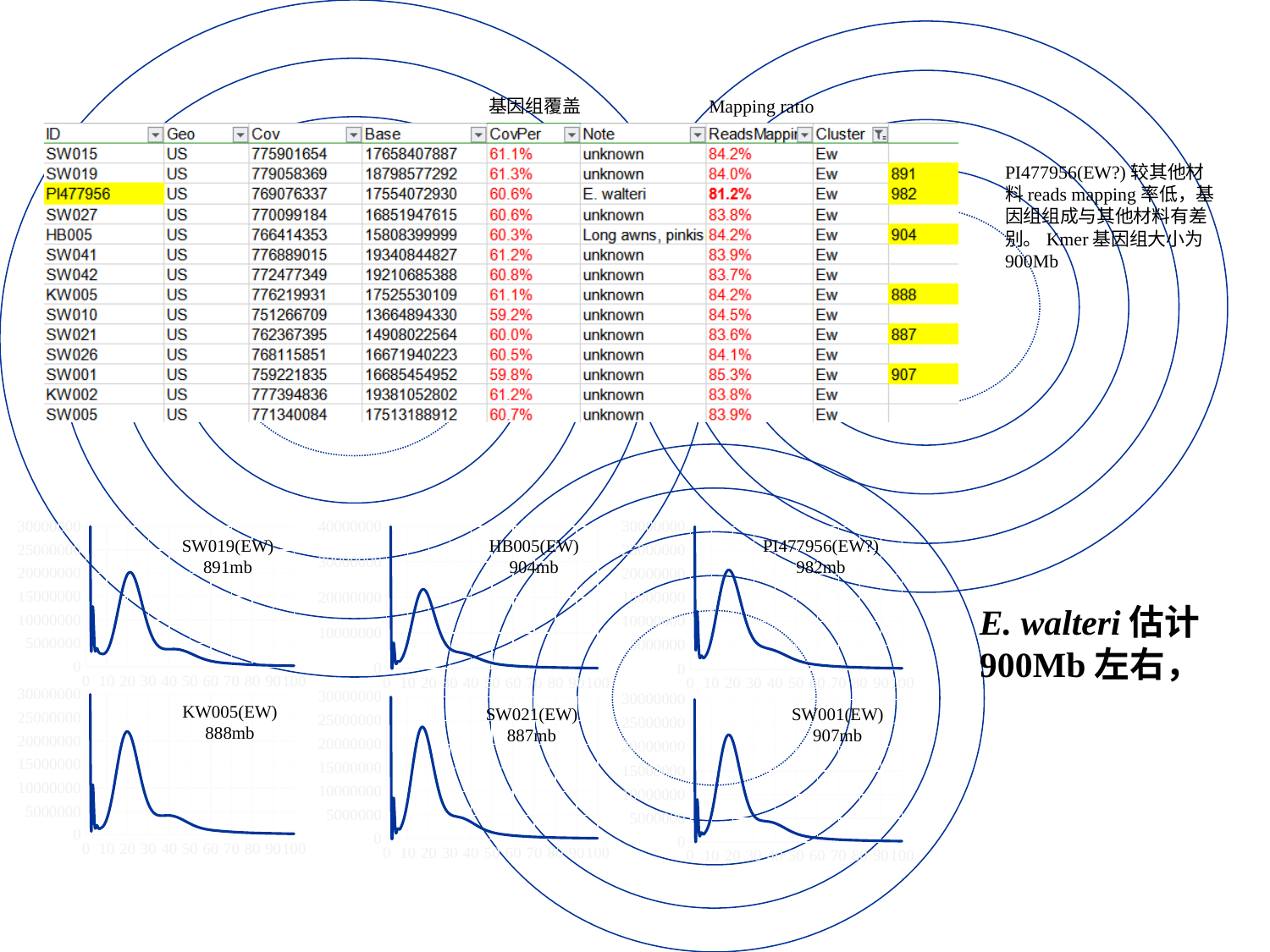
Which has the larger printed genome size, HB005(EW) or KW005(EW)? HB005(EW) What genome size is printed on the SW001(EW) chart? 907mb What is the difference between the genome sizes printed on the PI477956(EW?) chart and the SW021(EW) chart? 95mb What is the highest y-axis tick shown on the HB005(EW) chart? 40000000 Which of the six charts shows the largest genome size estimate? PI477956(EW?) What genome size is printed on the KW005(EW) chart? 888mb Which of the six charts shows the smallest genome size estimate? SW021(EW) In the KW005(EW) chart, is the peak value of the curve near x=20 greater or less than 15000000? greater What kind of chart is used for the six k-mer plots at the bottom of the slide? line chart In the SW019(EW) chart, do the values rise or fall along the x axis after the peak near x=20? fall What genome size is printed on the PI477956(EW?) chart? 982mb How many k-mer line charts are shown on the slide? 6